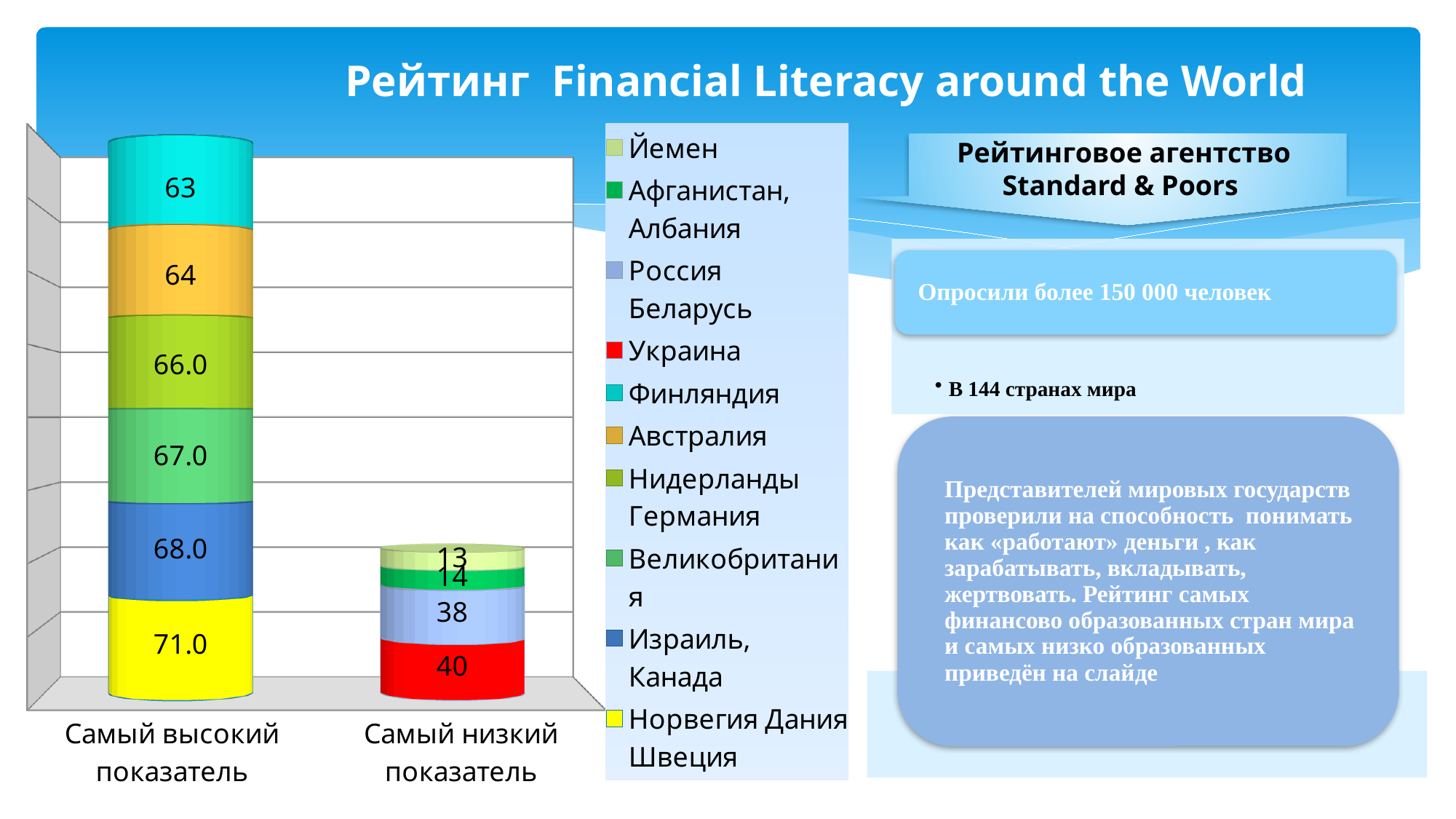
What is the difference between the values for Австралия (64) and Финляндия (63)? 1 What is the value for Украина in the 'Самый низкий показатель' bar? 40 Which colour represents Украина in the chart legend? Red What is the total of the 'Самый низкий показатель' stacked bar? 105 Which is larger: the value for Израиль, Канада or the value for Великобритания? Израиль, Канада How many series does the chart legend list? 10 What is the value for Россия Беларусь in the 'Самый низкий показатель' bar? 38 What is the value for Норвегия Дания Швеция in the 'Самый высокий показатель' bar? 71.0 What is the value for Йемен in the 'Самый низкий показатель' bar? 13 What is the value for Финляндия in the 'Самый высокий показатель' bar? 63 How many categories are shown on the x axis of the chart? 2 What kind of chart is shown on the slide? Stacked bar chart